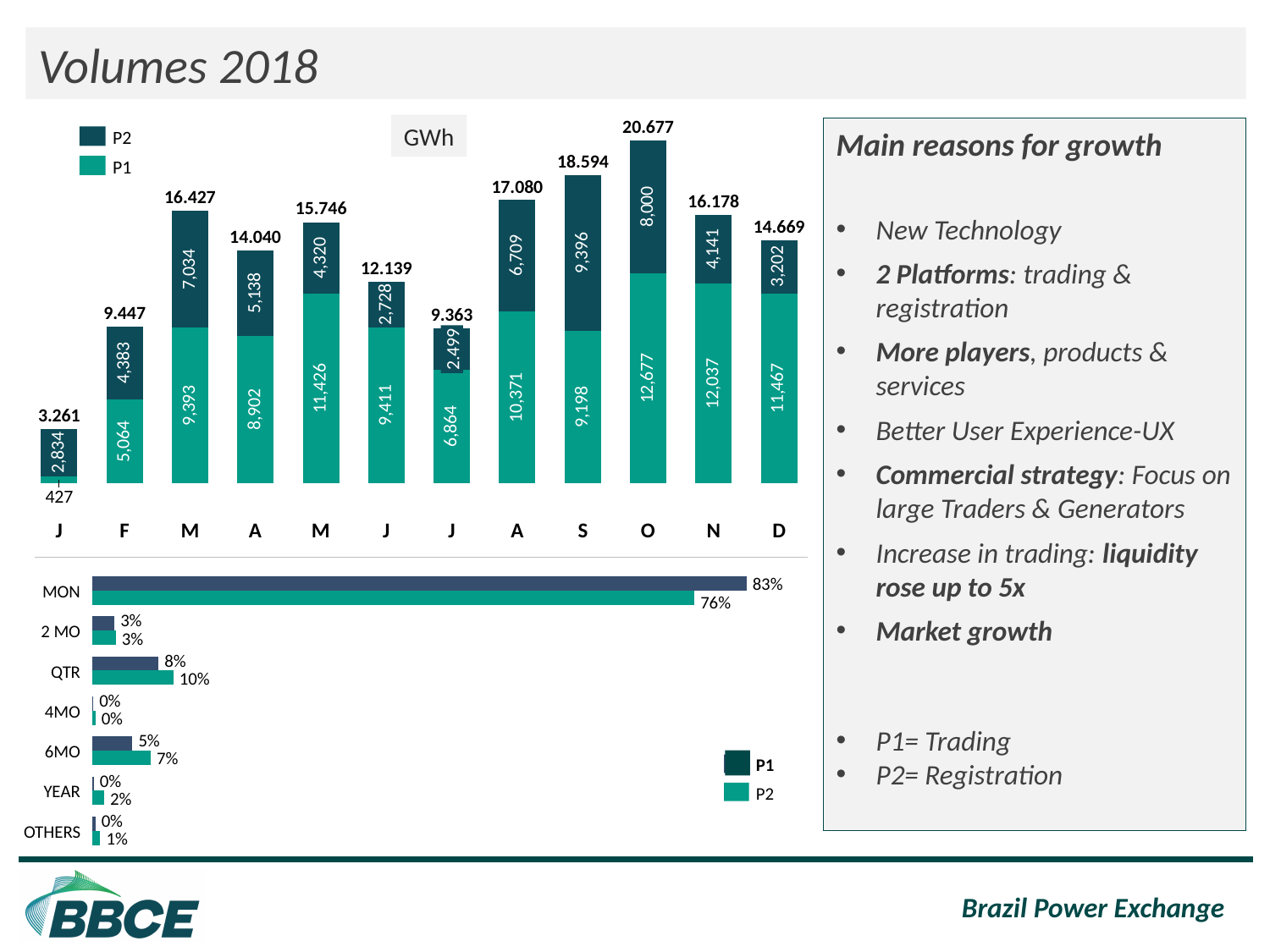
In the top chart, what is the total volume shown for October (O)? 20.677 How many months are plotted in the top chart? 12 In the bottom chart, which category has the highest values? MON How many series does the legend of the top chart list? 2 In the bottom chart, which is larger: the P2 value for QTR or the P2 value for 6MO? QTR In the top chart, what is the difference between the P2 value for March (7,034) and the P2 value for April (5,138)? 1,896 In the top chart, which month has the highest total volume? O (October) In the top chart, which month has the lowest total volume? J (January) In the bottom chart, what is the P1 value for MON? 83% What kind of chart is the top chart on the slide (monthly volumes)? Stacked bar chart In the top chart, what is the P2 value for September (S)? 9,396 In the top chart, what is the P1 value for May (the second M)? 11,426